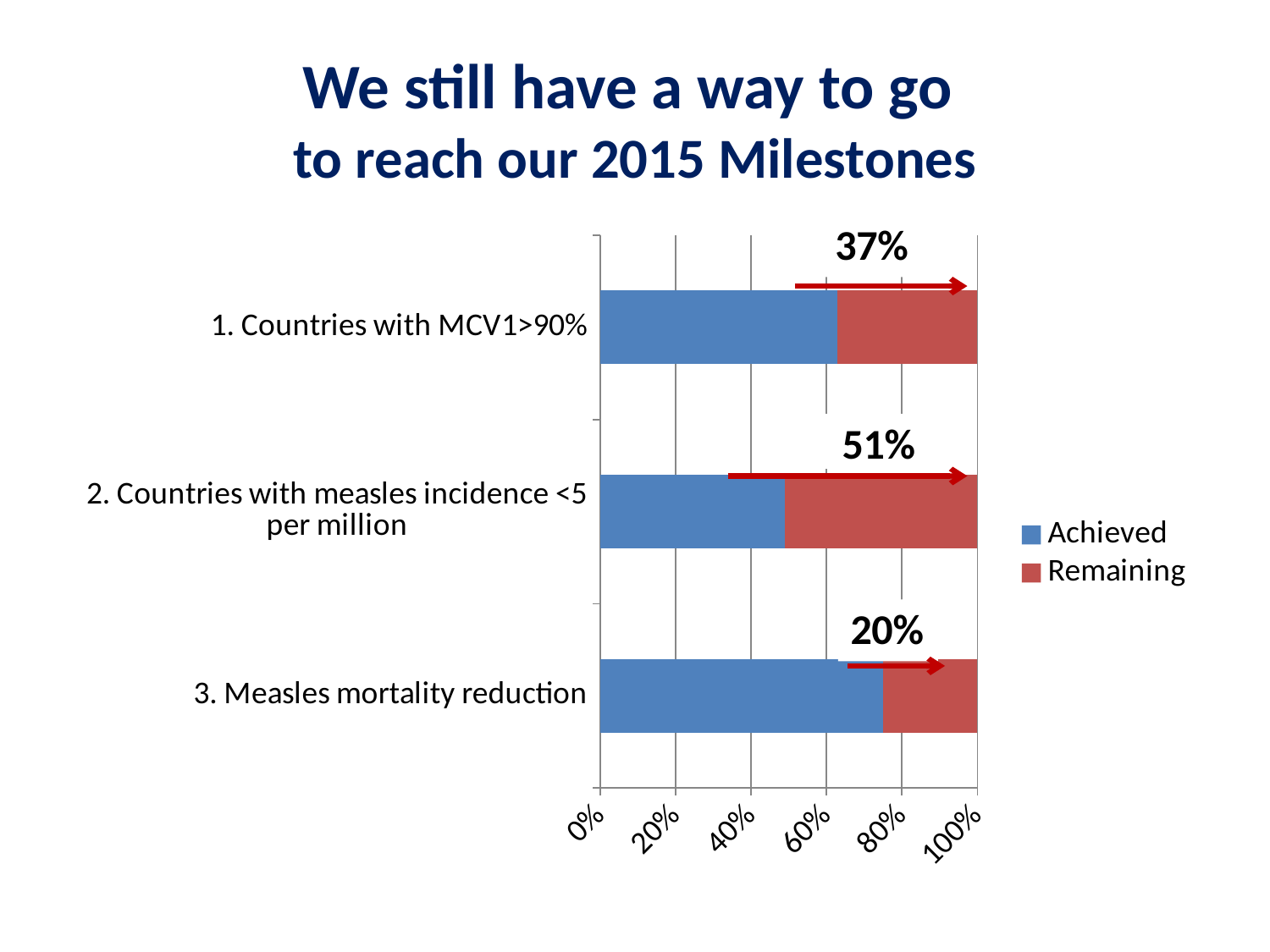
What kind of chart is shown on the slide? Stacked bar chart Which milestone has the largest Achieved portion? 3. Measles mortality reduction What percentage is annotated above the bar for '3. Measles mortality reduction'? 20% What percentage is annotated above the bar for '2. Countries with measles incidence <5 per million'? 51% Which is larger: the Remaining portion for '1. Countries with MCV1>90%' or for '3. Measles mortality reduction'? 1. Countries with MCV1>90% Is the Achieved value for '1. Countries with MCV1>90%' greater or less than 60%? greater Which milestone has the smallest Achieved portion? 2. Countries with measles incidence <5 per million What are the two series named in the legend? Achieved and Remaining How many series does the legend list? 2 What percentage is annotated above the bar for '1. Countries with MCV1>90%'? 37% Is the Achieved value for '2. Countries with measles incidence <5 per million' greater or less than 60%? less How many categories (milestones) are plotted in the chart? 3